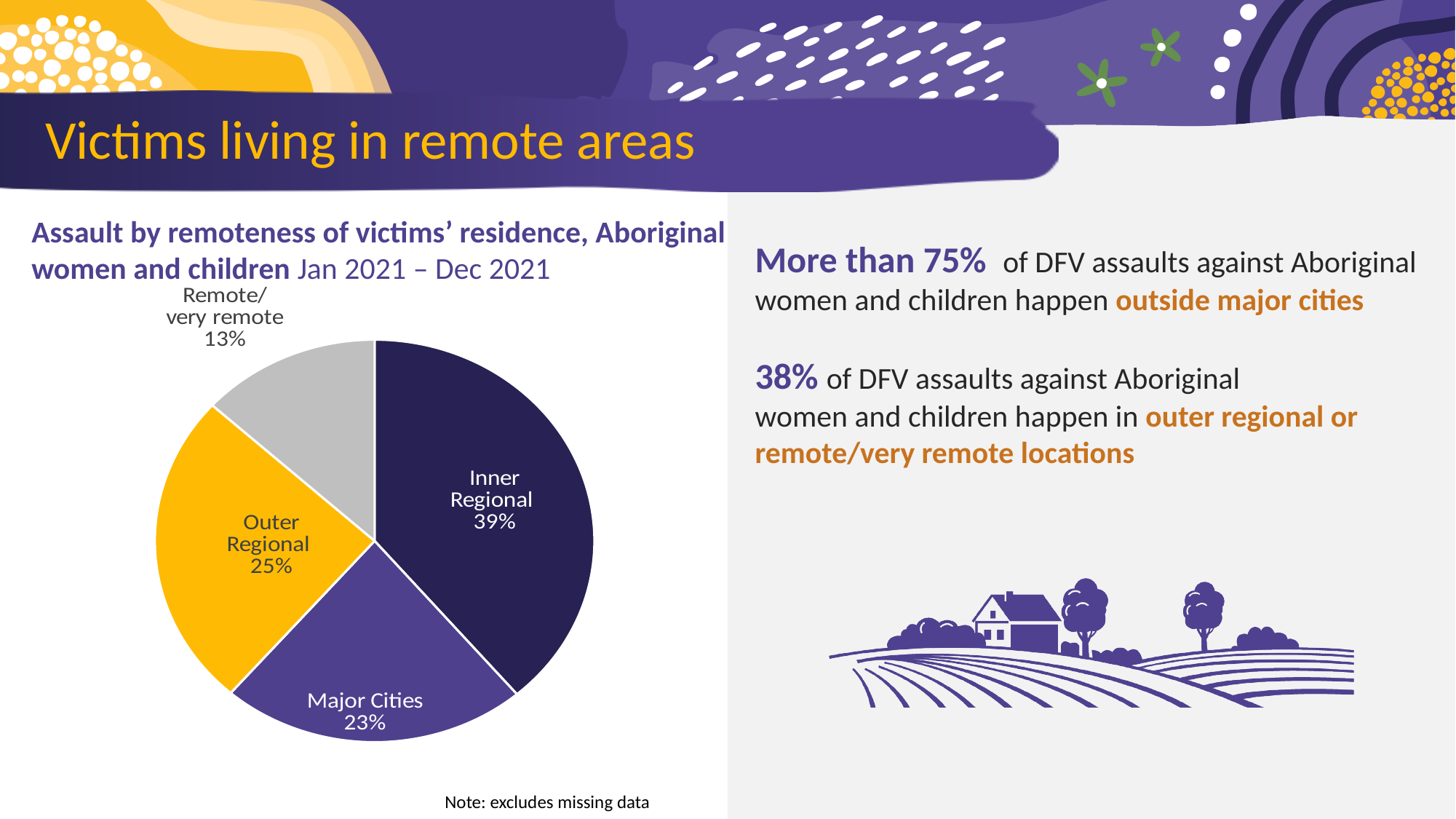
What type of chart is shown on the slide? pie chart How many slices does the pie chart have? 4 Which category has the largest slice of the pie? Inner Regional What share of assaults is attributed to Outer Regional? 25% What is the difference in percentage points between Inner Regional and Major Cities? 16 What share of assaults is attributed to Remote/very remote? 13% What share of assaults is attributed to Major Cities? 23% What is the title of the chart? Assault by remoteness of victims' residence, Aboriginal women and children Jan 2021 – Dec 2021 Which is larger, the Outer Regional slice or the Major Cities slice? Outer Regional Which category has the smallest slice of the pie? Remote/very remote What share of assaults is attributed to Inner Regional? 39% What is the combined share of Outer Regional and Remote/very remote? 38%